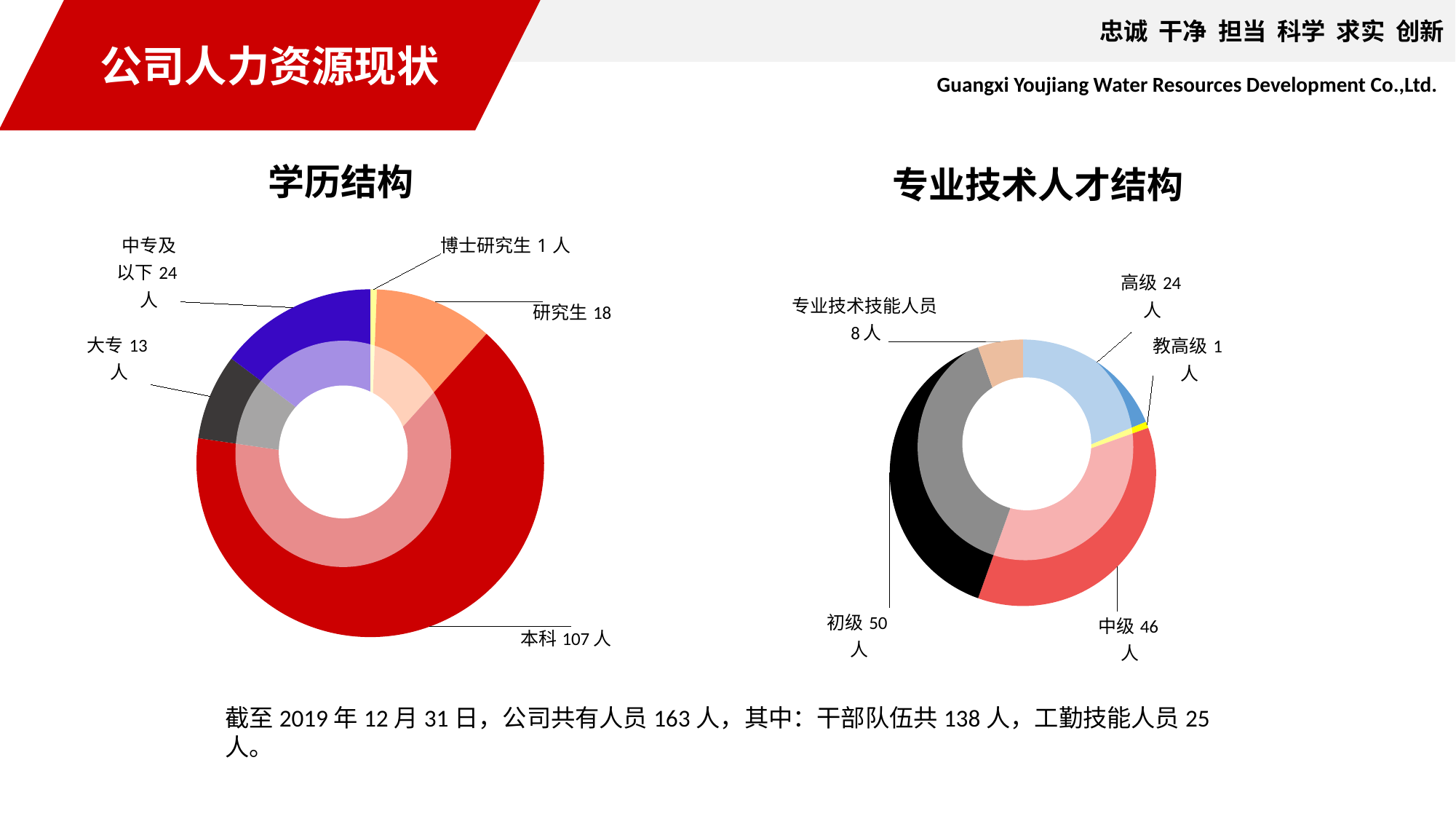
In the 学历结构 chart on the left, what is the difference between 中专及以下 and 大专? 11 In the 专业技术人才结构 chart on the right, which category has the largest value? 初级 In the 学历结构 chart on the left, which category has the largest value? 本科 In the 学历结构 chart on the left, what is the value for 本科? 107 人 In the 学历结构 chart on the left, how many categories are shown? 5 In the 专业技术人才结构 chart on the right, how many categories are shown? 5 In the 专业技术人才结构 chart on the right, what is the difference between 初级 and 中级? 4 What type of chart is the 学历结构 chart on the left? Doughnut (pie) chart In the 学历结构 chart on the left, what is the value for 中专及以下? 24 人 In the 专业技术人才结构 chart on the right, which is larger, 高级 or 专业技术技能人员? 高级 In the 专业技术人才结构 chart on the right, what is the value for 中级? 46 人 In the 学历结构 chart on the left, which category has the smallest value? 博士研究生